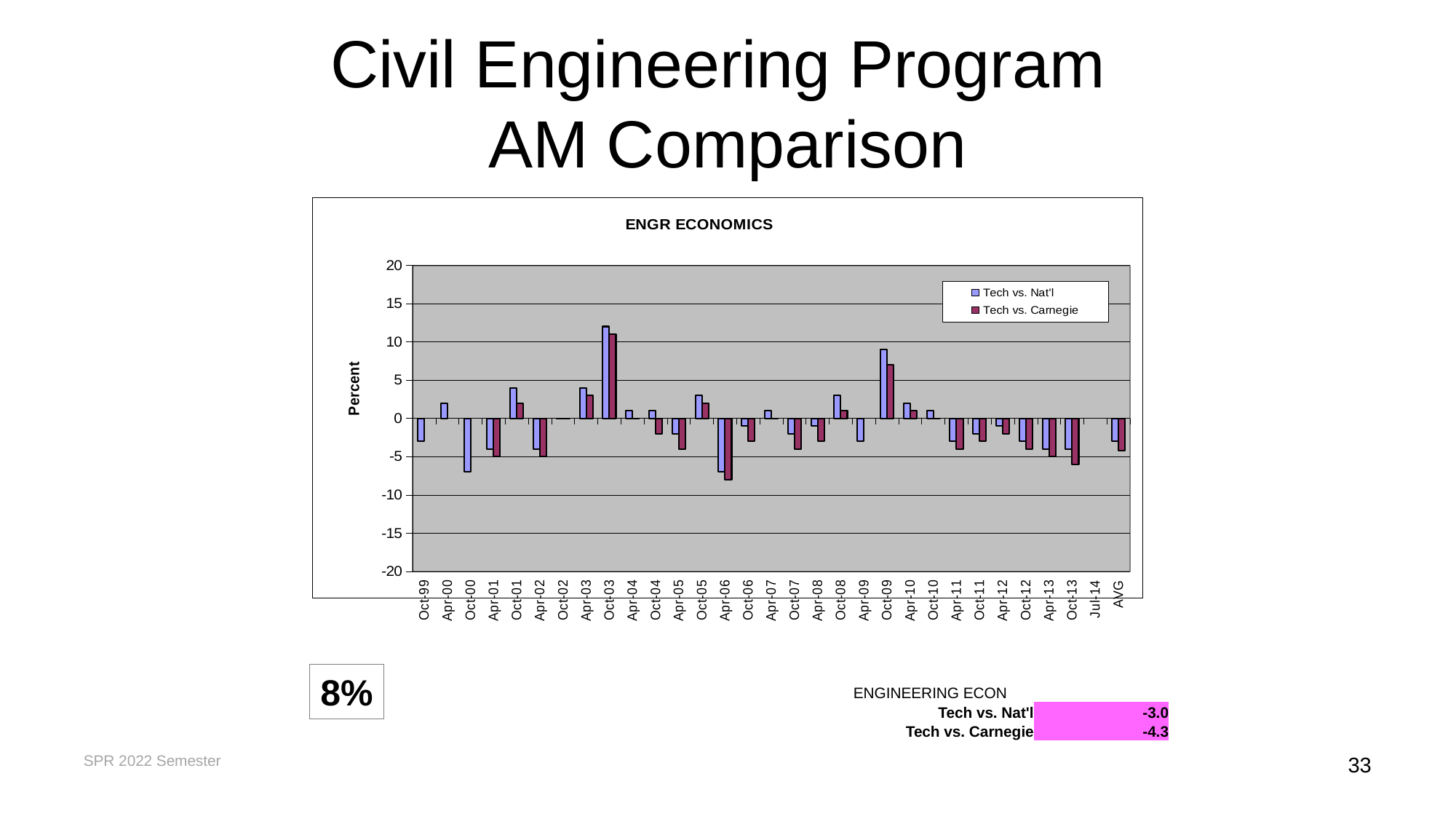
How many series does the legend of the ENGR ECONOMICS chart list? 2 Is the Tech vs. Nat'l value for Oct-00 greater or less than -5? less What are the two series named in the legend of the ENGR ECONOMICS chart? Tech vs. Nat'l and Tech vs. Carnegie In which period is the Tech vs. Nat'l bar highest in the ENGR ECONOMICS chart? Oct-03 Which is larger for Tech vs. Nat'l: the value for Oct-03 or the value for Oct-09? Oct-03 What kind of chart is shown on the slide? Bar chart How many categories are shown along the x axis of the ENGR ECONOMICS chart, including AVG? 31 According to the ENGINEERING ECON table below the chart, what is the Tech vs. Carnegie value? -4.3 What is the label on the vertical axis of the ENGR ECONOMICS chart? Percent Is the Tech vs. Carnegie value for Apr-06 greater or less than -5? less Is the Tech vs. Nat'l value for Oct-03 greater or less than 10? greater In which period is the Tech vs. Carnegie bar lowest in the ENGR ECONOMICS chart? Apr-06